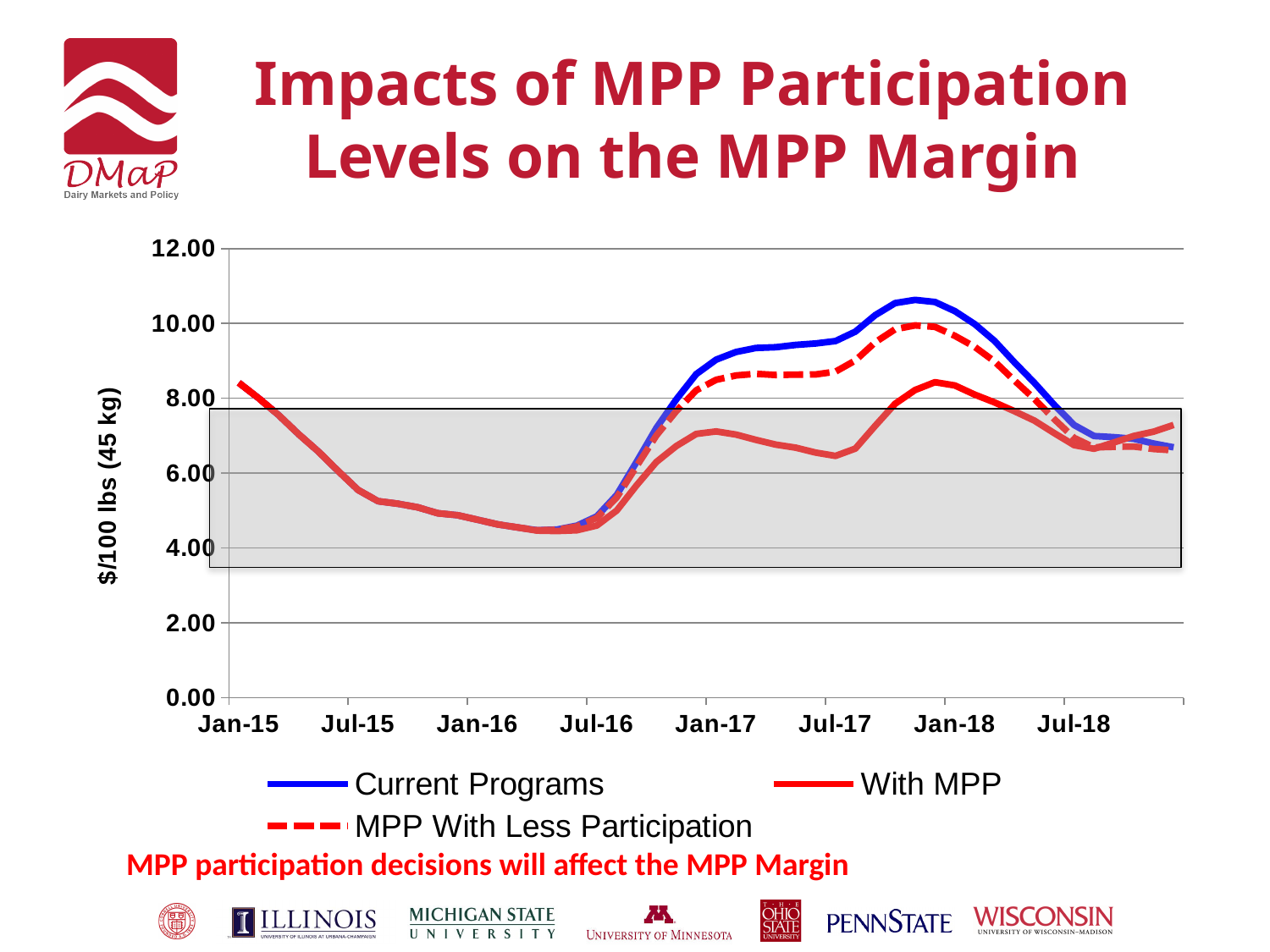
What kind of chart is shown on the slide? Line chart Which series reaches the highest peak on the chart? Current Programs At Jan-17, which is higher: MPP With Less Participation or With MPP? MPP With Less Participation Is the value for With MPP at Jul-17 greater or less than 8.00? less What is the title of the chart on the slide? Impacts of MPP Participation Levels on the MPP Margin Is the value at Jul-16 greater or less than 6.00? less At Jan-18, which is higher: Current Programs or With MPP? Current Programs How many series does the legend list? 3 Do the values rise or fall from Jan-15 to Jul-15? Fall Is the value for Current Programs at Jan-18 greater or less than 10.00? greater What is the label on the vertical axis? $/100 lbs (45 kg)